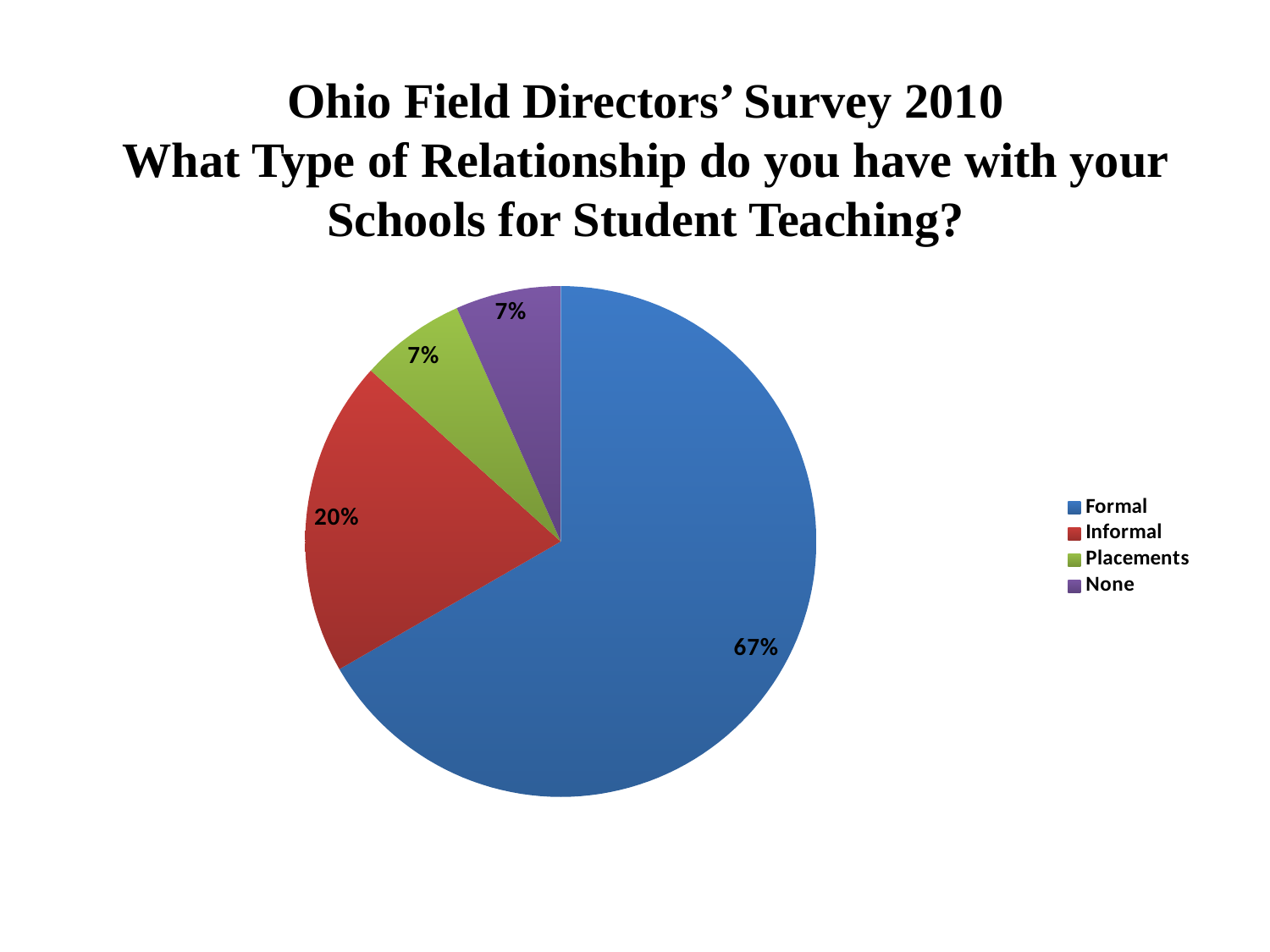
What share of the pie does None represent? 7% What share of the pie does Placements represent? 7% What type of chart is shown on the slide? pie chart Which category has the largest slice of the pie? Formal What share of the pie does Formal represent? 67% Which is larger, the Informal slice or the Placements slice? Informal What is the combined share of Placements and None? 14% What is the difference in percentage points between Formal and Informal? 47 Which colour represents the Informal category in the pie chart? red What survey is named in the first line of the chart title? Ohio Field Directors' Survey 2010 How many categories does the legend list? 4